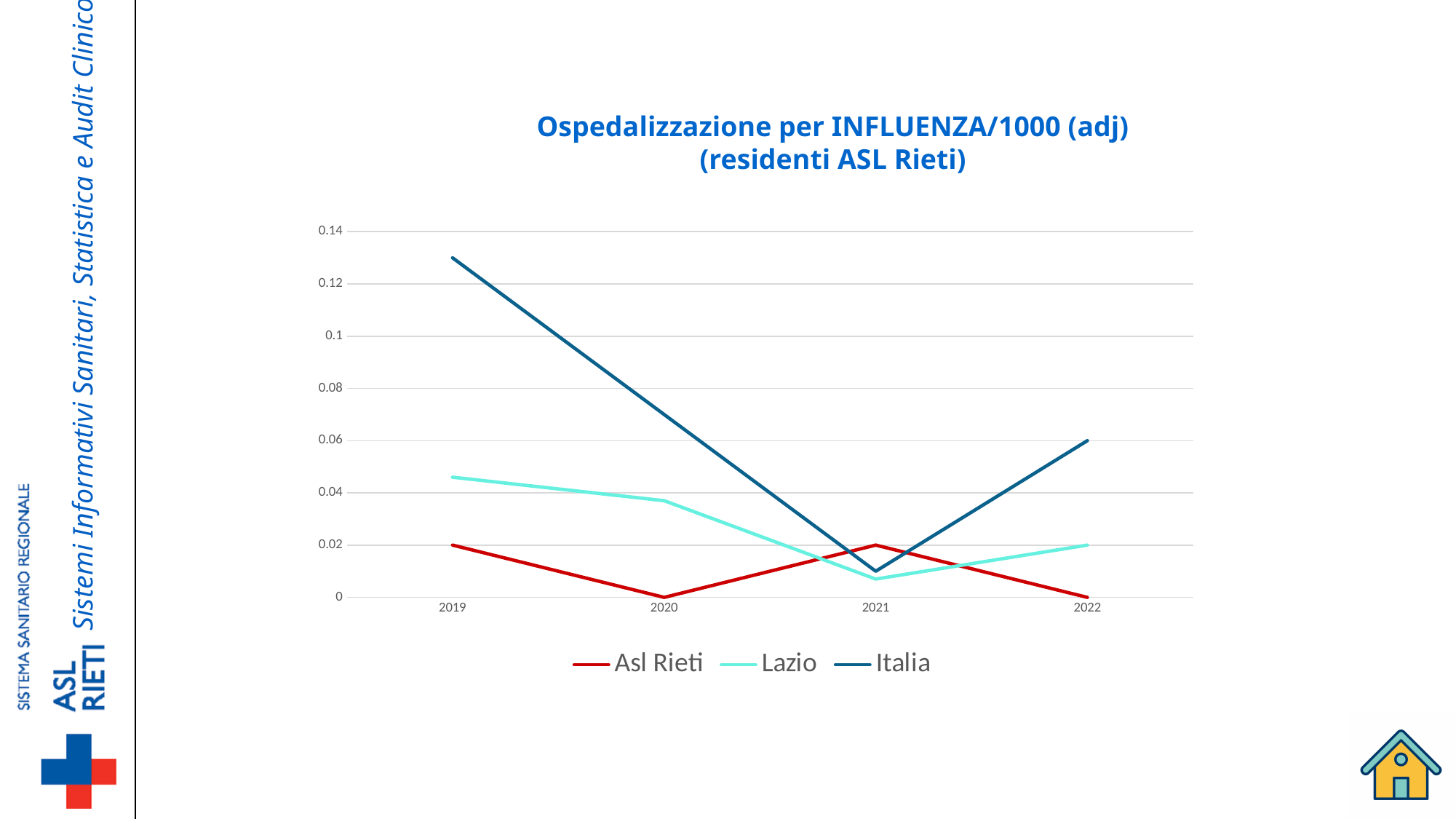
What kind of chart is shown on the slide? line chart What is the value for Italia in 2022? 0.06 In which year is the value for Italia highest? 2019 Is the value for Lazio in 2019 greater or less than 0.04? greater How many years are shown on the x axis? 4 What is the value for Asl Rieti in 2019? 0.02 Is the value for Italia in 2019 greater or less than 0.12? greater Does the value for Italia rise or fall from 2019 to 2021? fall In 2019, which series has the larger value, Italia or Lazio? Italia In which year is the value for Italia lowest? 2021 What is the value for Asl Rieti in 2020? 0 How many series does the legend list? 3